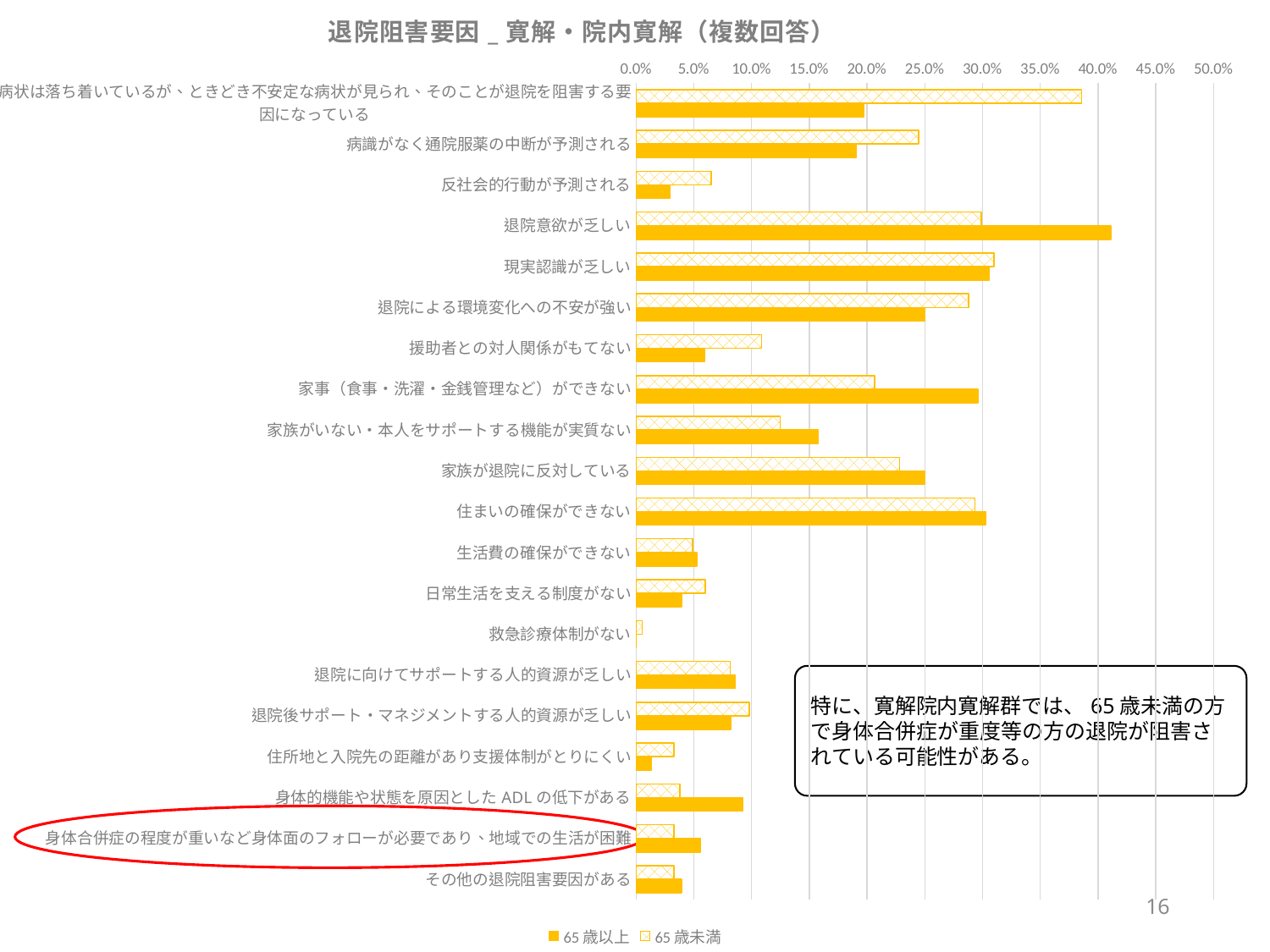
For 家事（食事・洗濯・金銭管理など）ができない, which series has the larger value, 65歳以上 or 65歳未満? 65歳以上 Is the 65歳以上 value for 反社会的行動が予測される greater or less than 5.0%? less What kind of chart is shown on the slide? bar chart For the 65歳未満 series, which category has the highest value? 病状は落ち着いているが、ときどき不安定な病状が見られ、そのことが退院を阻害する要因になっている Is the 65歳未満 value for 退院による環境変化への不安が強い greater or less than 25.0%? greater What are the two legend entries of the chart? 65歳以上, 65歳未満 For the 65歳以上 series, which category has the highest value? 退院意欲が乏しい What is the title of the chart? 退院阻害要因＿寛解・院内寛解（複数回答） How many categories (discharge-hindering factors) are plotted on the chart? 20 For the 65歳以上 series, which category has the lowest value? 救急診療体制がない Is the 65歳以上 value for 退院意欲が乏しい greater or less than 35.0%? greater How many series does the legend list? 2